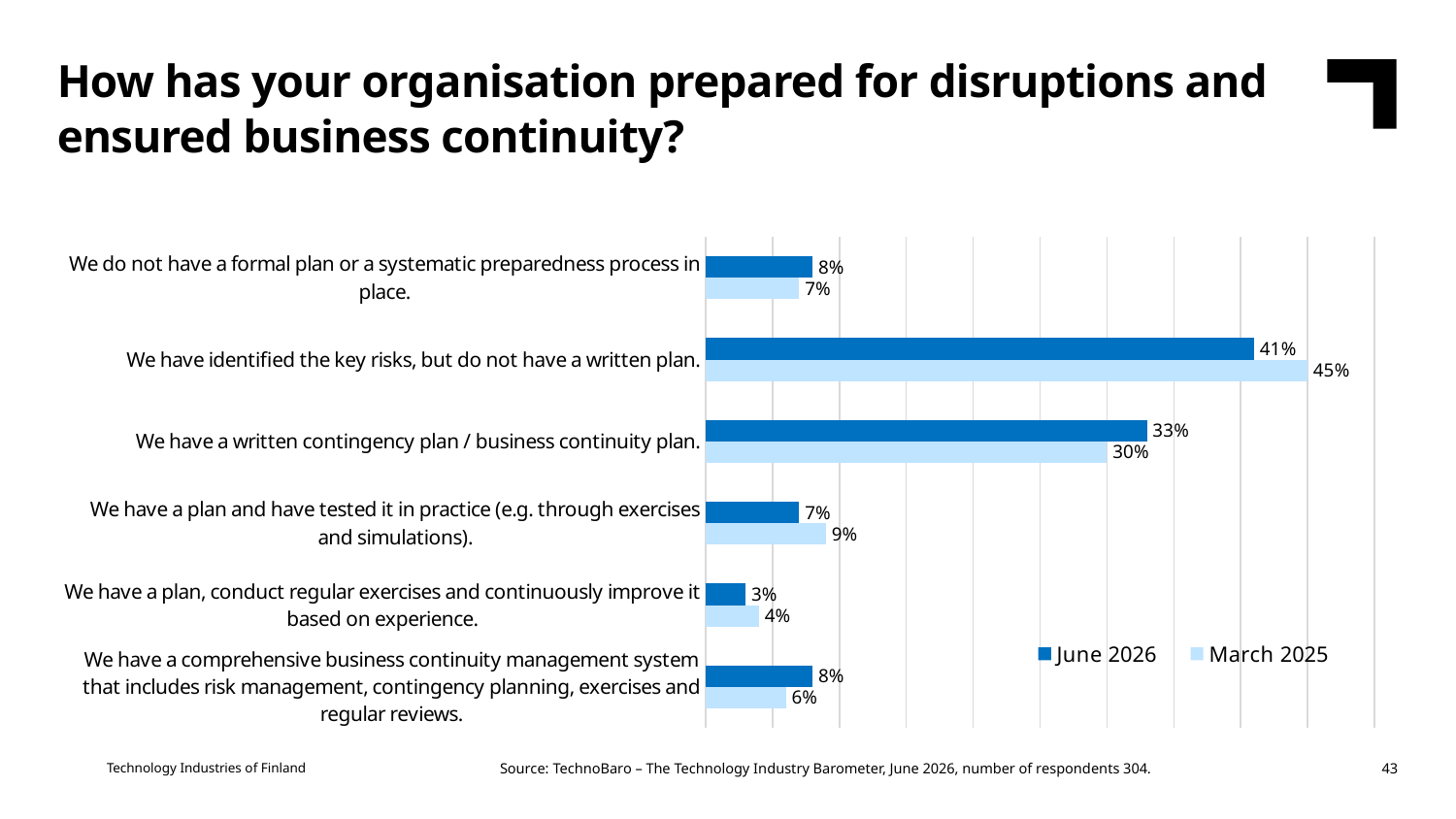
What is the March 2025 value for "We have a comprehensive business continuity management system that includes risk management, contingency planning, exercises and regular reviews."? 6% How many categories are shown in the chart? 6 What are the two series listed in the legend? June 2026 and March 2025 What is the March 2025 value for "We have a written contingency plan / business continuity plan."? 30% For "We have a plan and have tested it in practice (e.g. through exercises and simulations).", which is larger: the June 2026 value or the March 2025 value? March 2025 What kind of chart is shown on the slide? Bar chart What is the difference between the March 2025 and June 2026 values for "We have identified the key risks, but do not have a written plan."? 4% Which category has the lowest June 2026 value? We have a plan, conduct regular exercises and continuously improve it based on experience. What is the June 2026 value for "We have identified the key risks, but do not have a written plan."? 41% Which category has the highest March 2025 value? We have identified the key risks, but do not have a written plan. What is the June 2026 value for "We have a plan, conduct regular exercises and continuously improve it based on experience."? 3% How many series does the legend list? 2